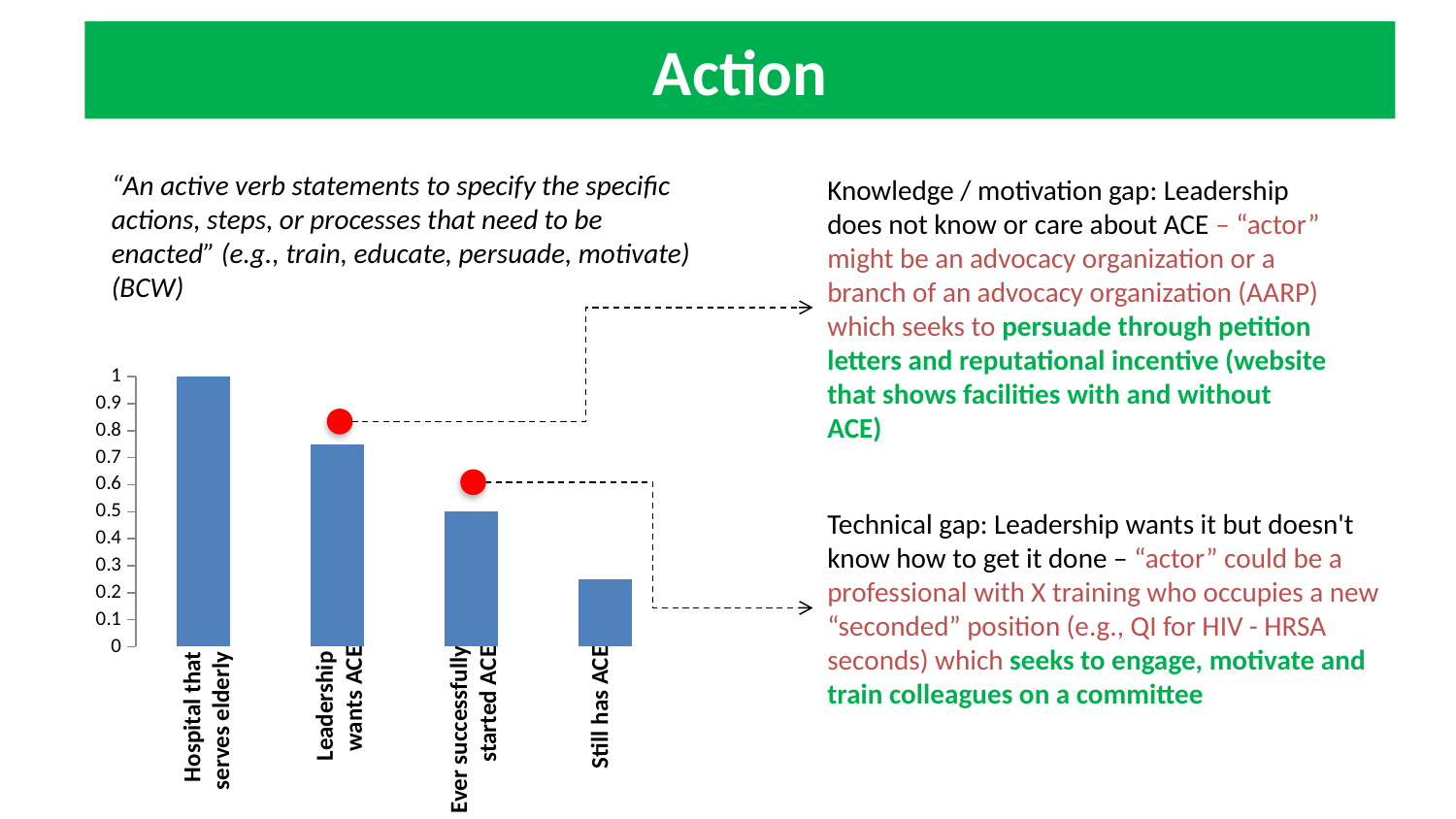
How many categories are shown on the chart? 4 Which category has the highest value? Hospital that serves elderly Which category has the lowest value? Still has ACE Which is larger, the value for "Leadership wants ACE" or the value for "Still has ACE"? Leadership wants ACE Is the value for "Still has ACE" greater or less than 0.3? less What kind of chart is shown on the slide? bar chart What is the value for "Hospital that serves elderly"? 1 Do the values rise or fall from left to right along the x axis? fall What is the difference between the values for "Hospital that serves elderly" and "Ever successfully started ACE"? 0.5 What is the value for "Ever successfully started ACE"? 0.5 Is the value for "Leadership wants ACE" greater or less than 0.7? greater What is the highest value shown on the vertical axis? 1